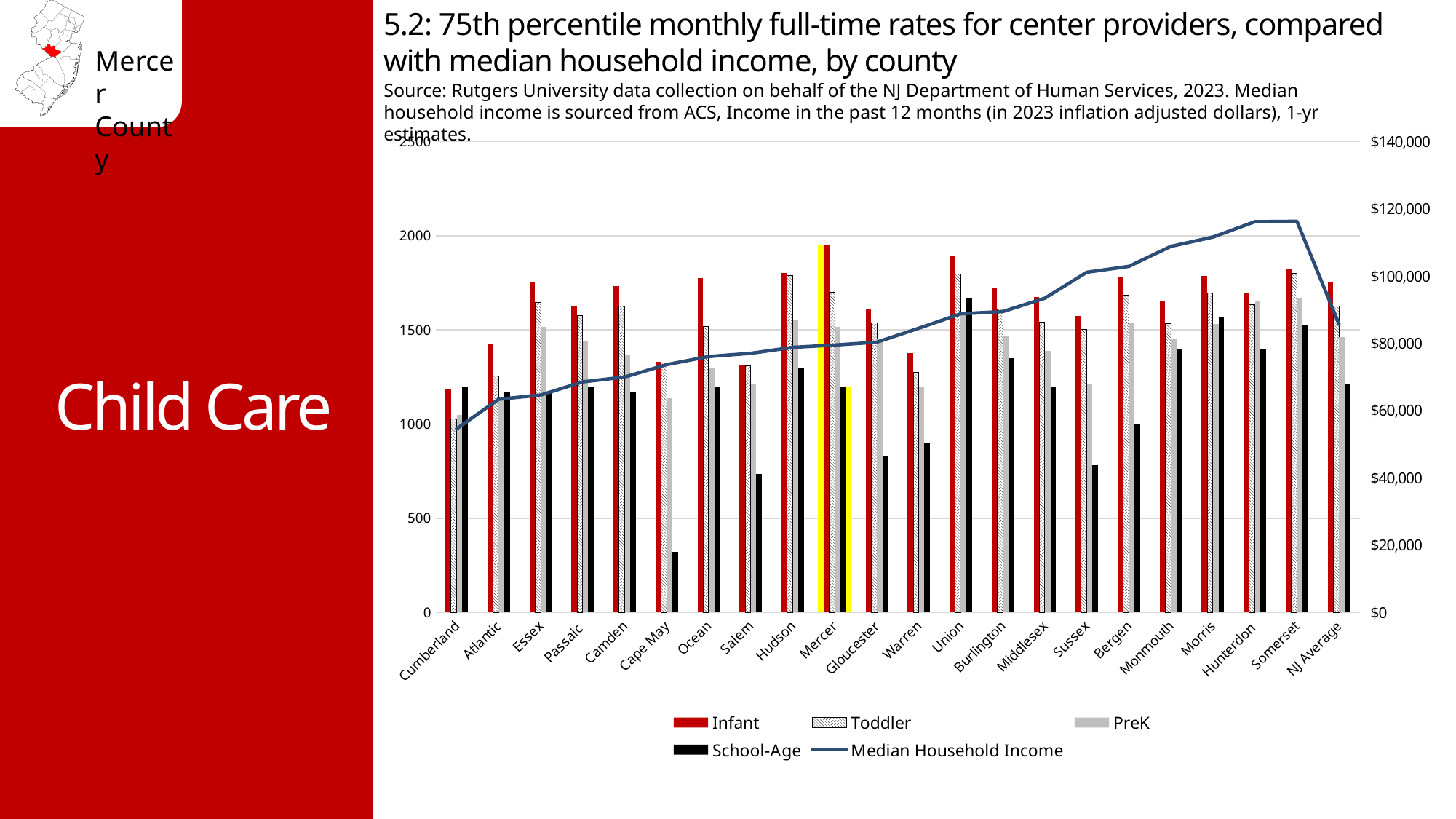
Which is larger, the School-Age rate for Union or for Warren? Union Does the Median Household Income line generally rise or fall from Cumberland to Somerset? rise Is the Median Household Income for Somerset greater or less than $100,000? greater Is the Infant rate for Mercer greater or less than 1500? greater How many series does the chart's legend list? 5 Is the Median Household Income for Cumberland greater or less than $80,000? less What kind of chart is shown on the slide? bar chart with a line Which county has the highest Infant rate? Mercer Which county has the lowest Infant rate? Cumberland Which county has the lowest School-Age rate? Cape May How many counties/categories are shown along the x axis of the chart? 22